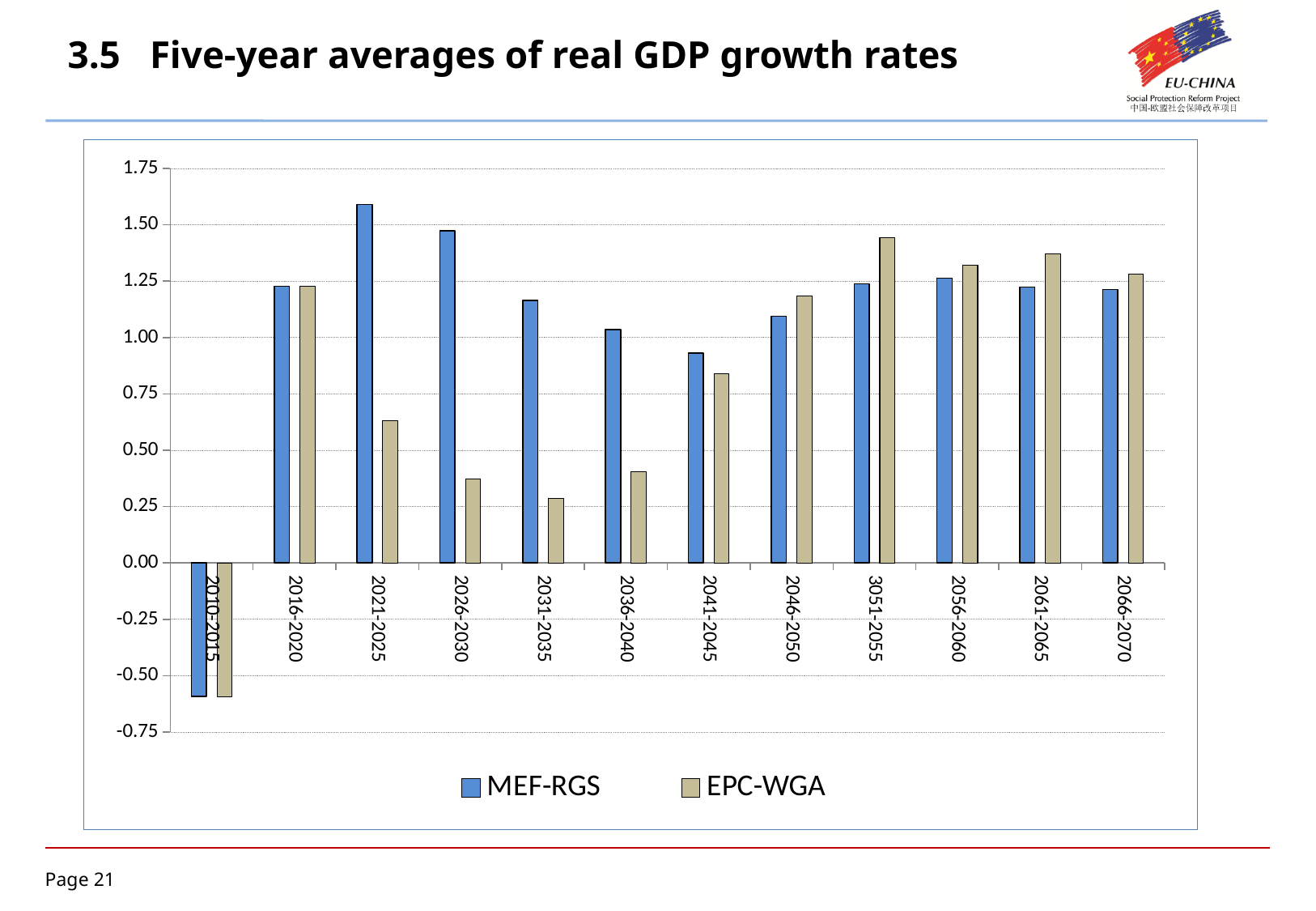
Which period has the highest MEF-RGS value? 2021-2025 Is the MEF-RGS value for 2041-2045 greater or less than 1.00? less Is the EPC-WGA value for 2031-2035 greater or less than 0.50? less For 2021-2025, which series has the larger value, MEF-RGS or EPC-WGA? MEF-RGS Is the MEF-RGS value for 2021-2025 greater or less than 1.50? greater Which period has the lowest MEF-RGS value? 2010-2015 What kind of chart is shown on the slide? bar chart Which colour represents the EPC-WGA series? tan Which period has the highest EPC-WGA value? 3051-2055 How many five-year periods are shown on the x axis? 12 For 3051-2055, which series has the larger value, MEF-RGS or EPC-WGA? EPC-WGA How many series does the legend list? 2